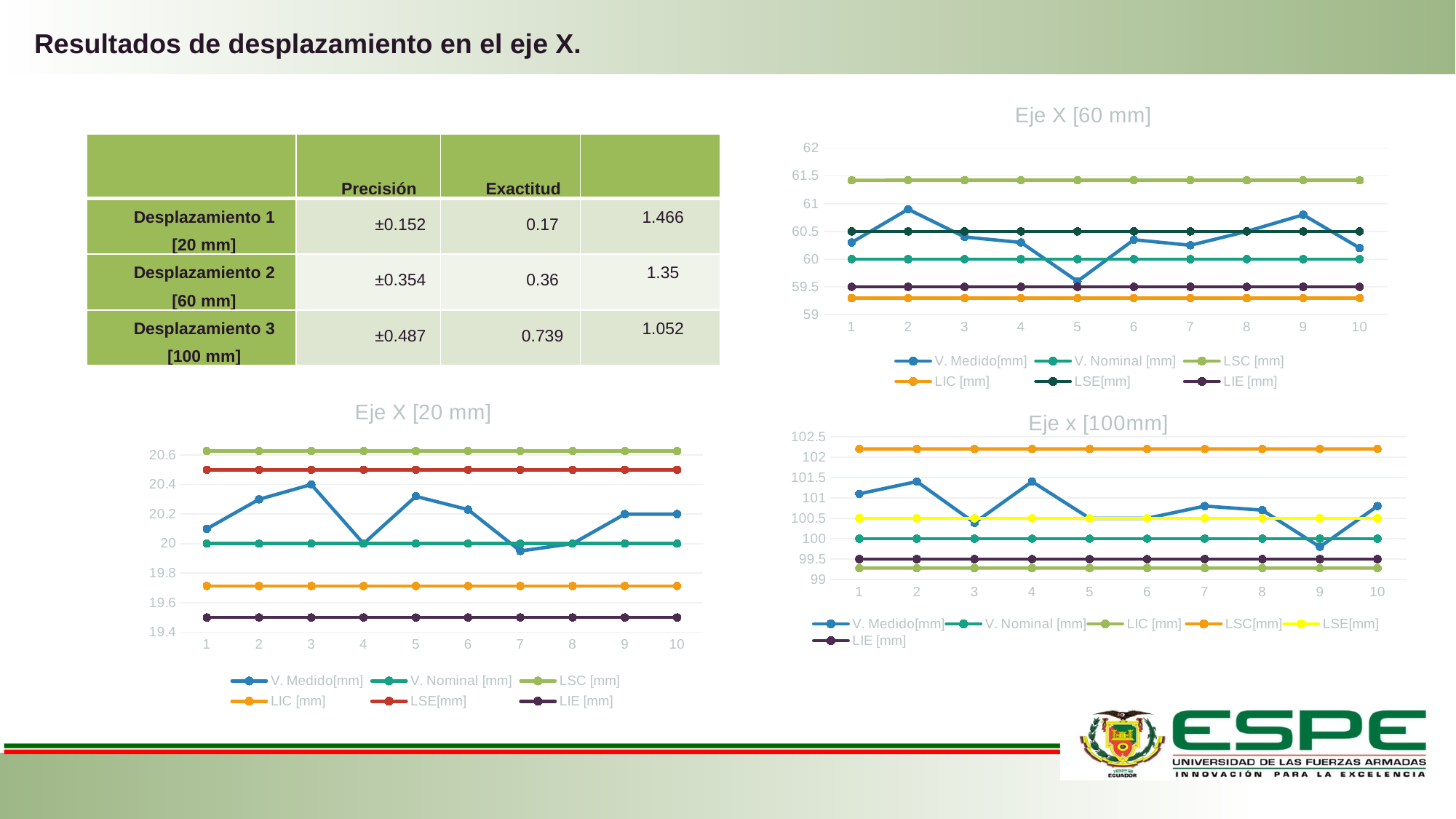
In the 'Eje X [60 mm]' chart, is the V. Medido[mm] value at point 5 greater or less than 60? less What kind of chart is the 'Eje X [20 mm]' chart? line chart In the 'Eje X [20 mm]' chart, what is the value of the V. Nominal [mm] series? 20 In the 'Eje x [100mm]' chart, what is the value of the LSE[mm] series? 100.5 How many points are plotted along the x axis in the 'Eje x [100mm]' chart? 10 In the 'Eje X [60 mm]' chart, what is the value of the LIE [mm] series? 59.5 In the 'Eje X [20 mm]' chart, is the V. Medido[mm] value at point 3 greater or less than 20.2? greater In the 'Eje X [60 mm]' chart, what is the value of the LSE[mm] series? 60.5 In the 'Eje x [100mm]' chart, what is the value of the V. Nominal [mm] series? 100 In the 'Eje x [100mm]' chart, is the V. Medido[mm] value at point 2 greater or less than 101? greater In the 'Eje X [60 mm]' chart, which series is plotted at the highest value? LSC [mm] How many series does the legend of the 'Eje X [60 mm]' chart list? 6